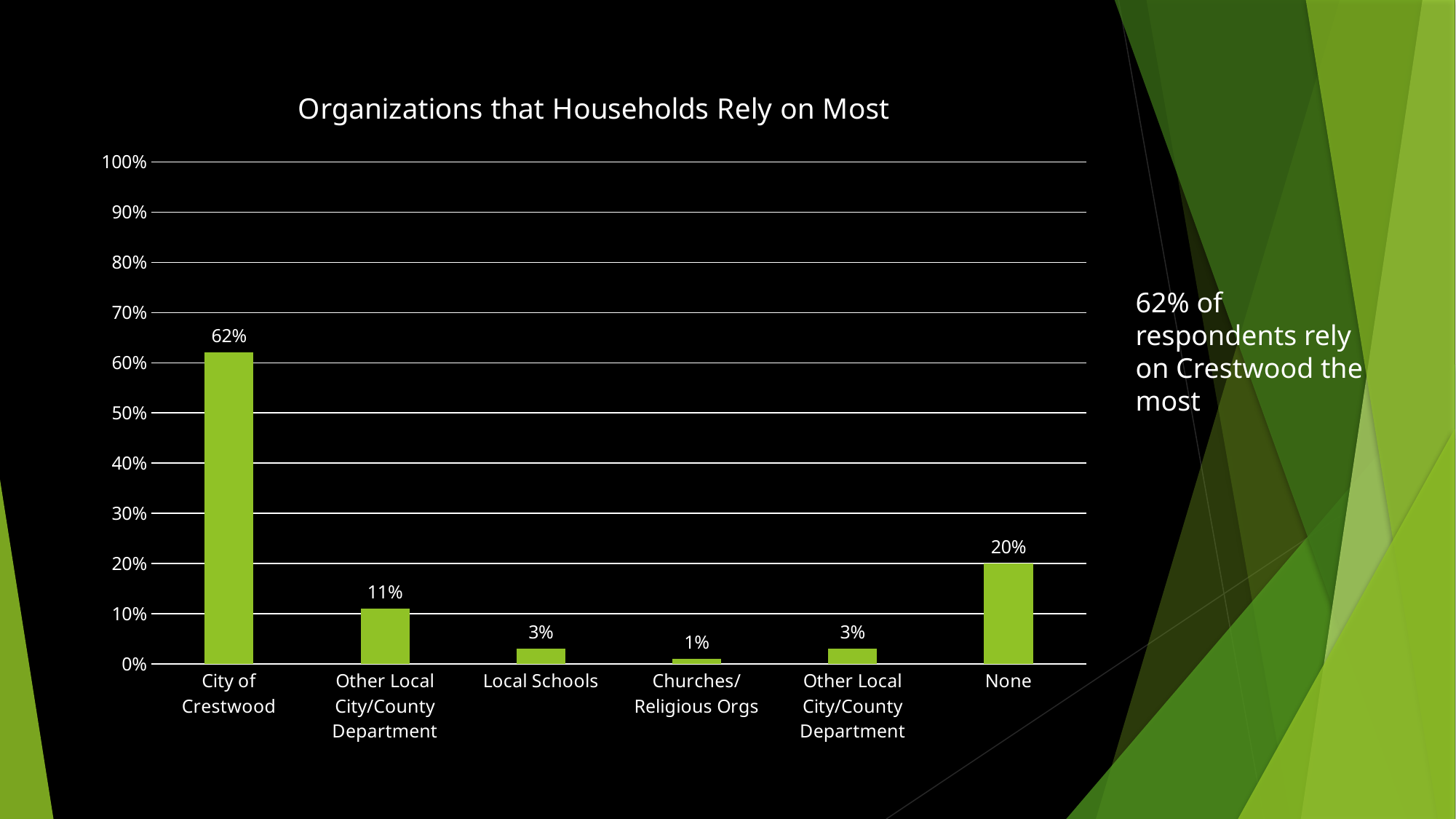
What is the value for City of Crestwood? 62% What is the value for Churches/Religious Orgs? 1% Which category has the lowest value? Churches/Religious Orgs How many categories are shown on the x axis? 6 Which category has the highest value? City of Crestwood What is the value for Local Schools? 3% Which is larger, the value for None or the value for Local Schools? None What is the value of the second bar from the left, labelled Other Local City/County Department? 11% What is the difference between the values for City of Crestwood and None? 42% What is the title of the chart? Organizations that Households Rely on Most What is the value for None? 20% What kind of chart is shown on the slide? bar chart